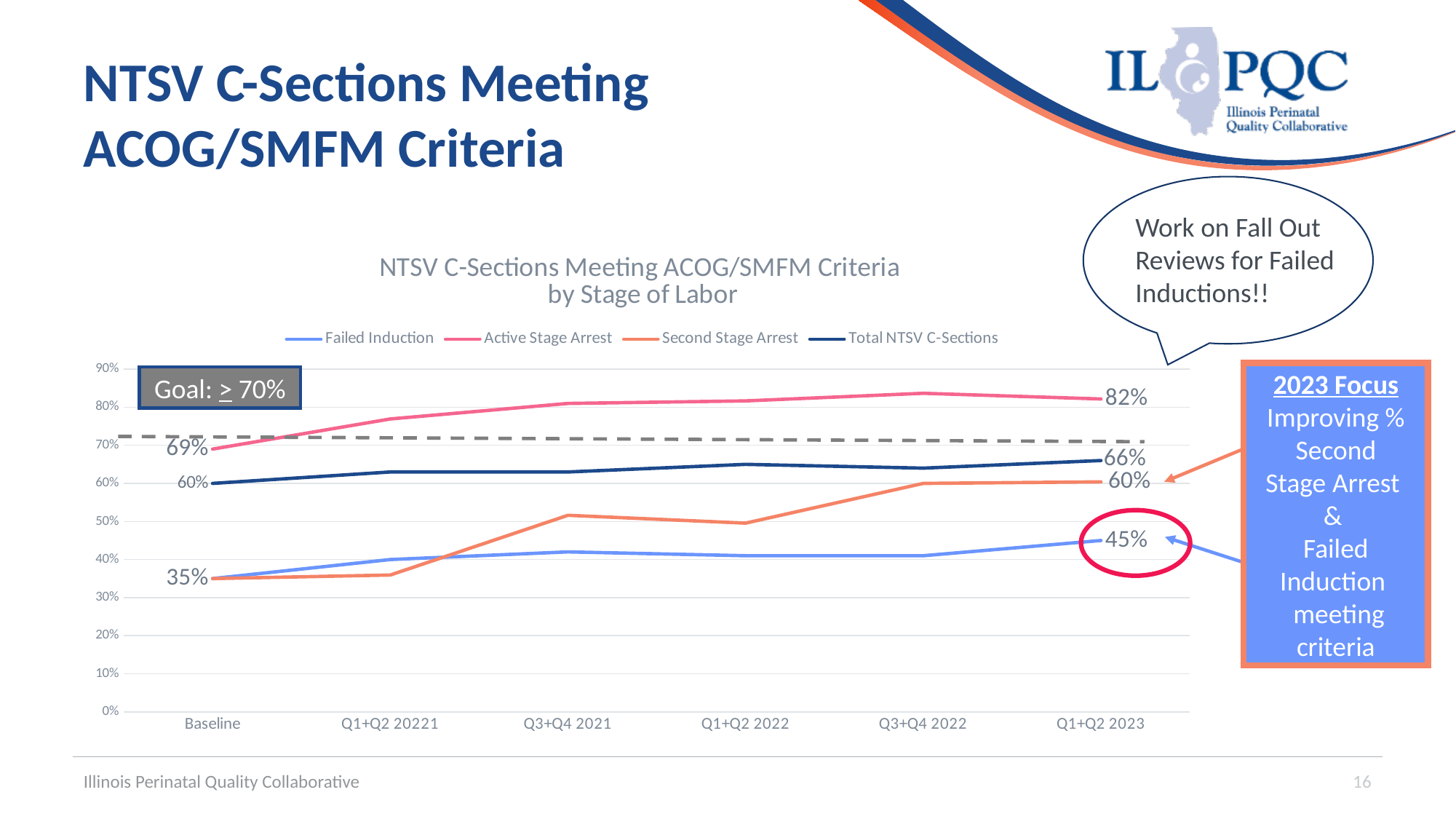
What is the Second Stage Arrest value at Q1+Q2 2023? 60% Which series has the highest value at Q1+Q2 2023? Active Stage Arrest By how many percentage points did Active Stage Arrest increase from Baseline (69%) to Q1+Q2 2023 (82%)? 13 percentage points Is the Failed Induction value at Q1+Q2 2022 greater or less than 50%? less What is the Active Stage Arrest value at Q1+Q2 2023? 82% What is the Total NTSV C-Sections value at Baseline? 60% How many time periods are shown on the x axis of the chart? 6 What is the Failed Induction value at Q1+Q2 2023? 45% Which series has the lowest value at Q1+Q2 2023? Failed Induction What kind of chart is shown on the slide? line chart What goal percentage is shown by the dashed line on the chart? 70% How many series does the chart legend list? 4